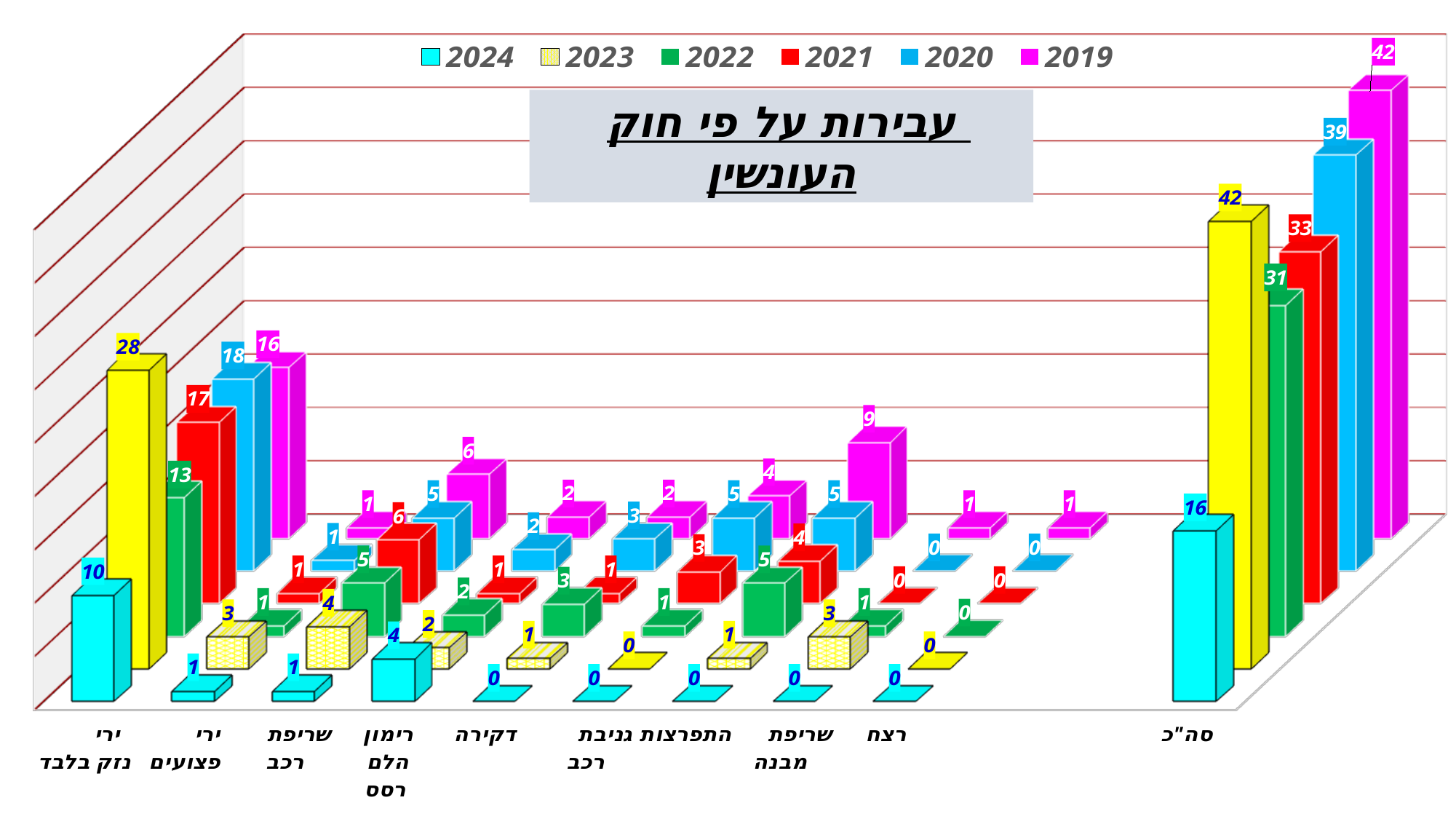
What is the value for 2024 in the רימון הלם רסס category? 4 What kind of chart is shown on the slide? bar chart Which year has the highest value in the ירי נזק בלבד category? 2023 What is the title of the chart? עבירות על פי חוק העונשין How many series does the legend list? 6 What is the value for 2020 in the סה"כ category? 39 What is the value for 2024 in the ירי נזק בלבד category? 10 What is the value for 2019 in the שריפת מבנה category? 1 What is the value for 2023 in the סה"כ category? 42 Which year has the lowest value in the סה"כ category? 2024 Which is larger in the סה"כ category, the value for 2021 or the value for 2022? 2021 What is the difference between the 2023 and 2024 values in the סה"כ category? 26